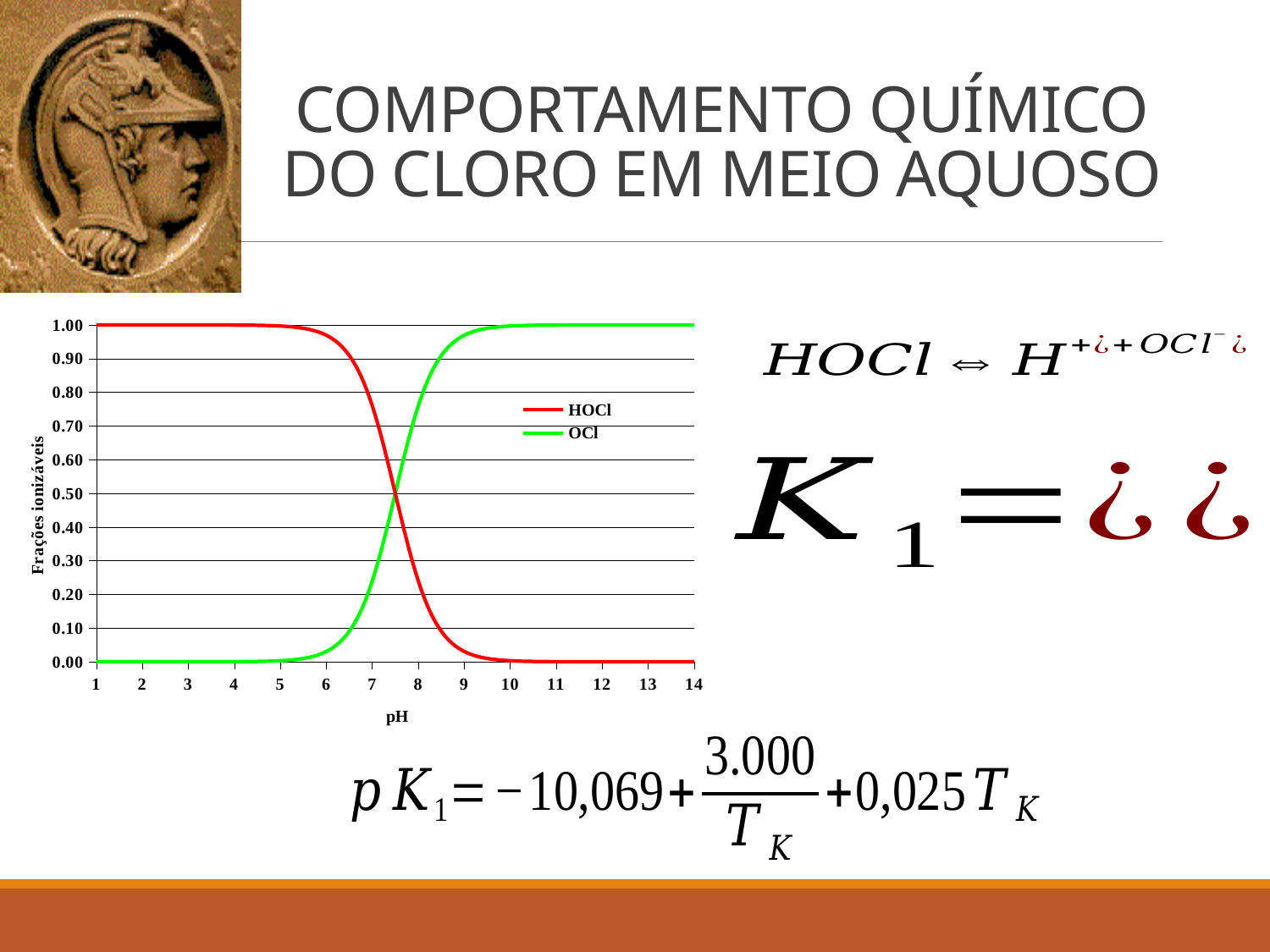
Is the value for HOCl at pH 10 greater or less than 0.10? less What are the two series named in the chart's legend? HOCl and OCl At pH 9, which series has the larger value, HOCl or OCl? OCl What kind of chart is shown on the slide? line chart Is the value for HOCl at pH 5 greater or less than 0.90? greater At pH 7, which series has the larger value, HOCl or OCl? HOCl How many series does the chart's legend list? 2 How many pH values are marked along the chart's x axis? 14 Is the value for OCl at pH 5 greater or less than 0.10? less Does the OCl series rise or fall as pH increases? rise What is the label of the chart's x axis? pH Does the HOCl series rise or fall as pH increases? fall